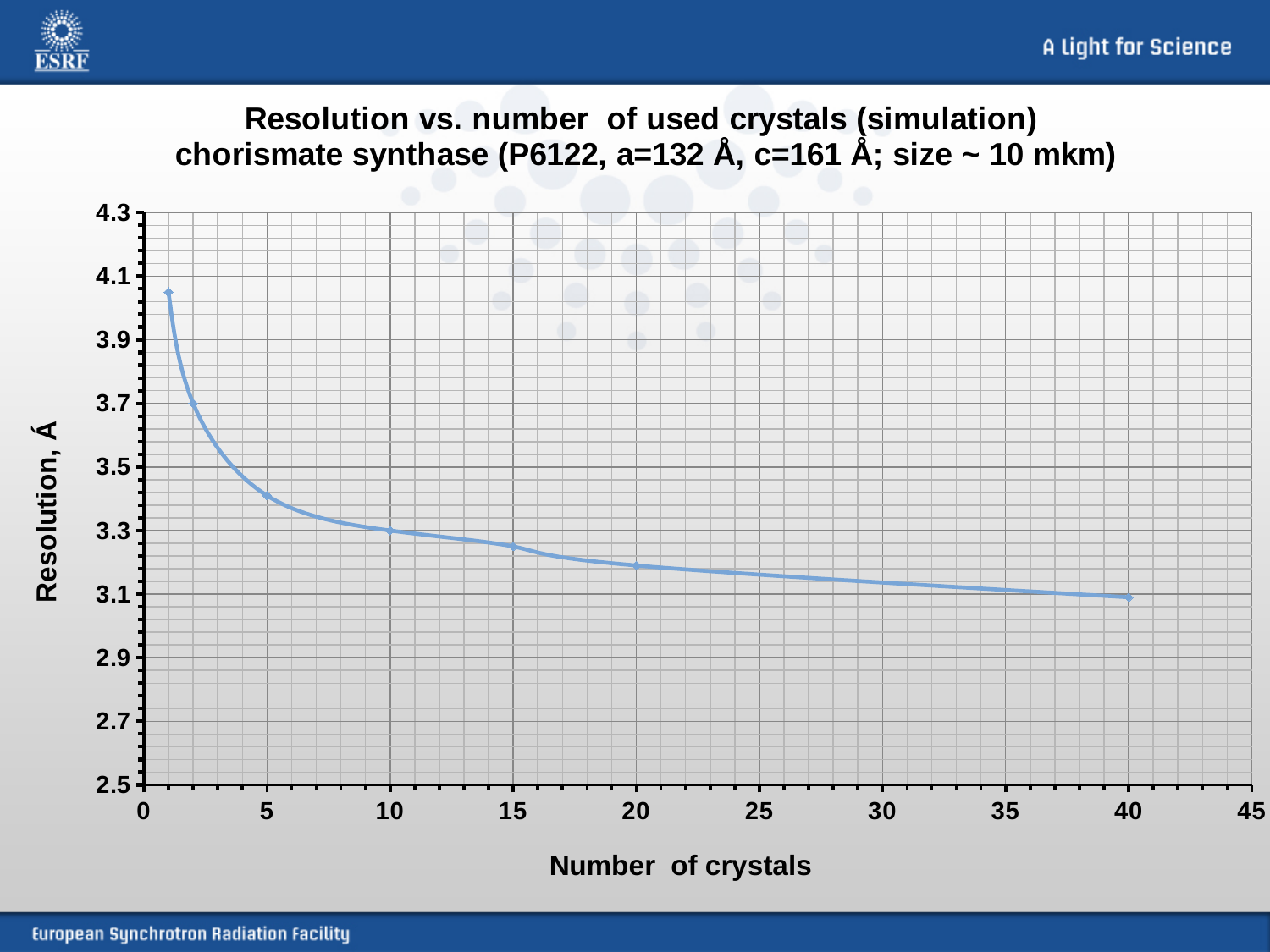
Does the resolution rise or fall as the number of crystals increases? fall Is the resolution for 1 crystal greater or less than 3.9? greater At which number of crystals is the resolution value highest? 1 Is the resolution for 2 crystals greater or less than 3.5? greater Is the resolution for 40 crystals greater or less than 3.3? less What is the label of the y axis? Resolution, Å Which has the larger resolution value, 2 crystals or 5 crystals? 2 crystals How many data points are plotted on the line? 7 At which number of crystals is the resolution value lowest? 40 What kind of chart is shown on the slide? line chart What is the label of the x axis? Number of crystals